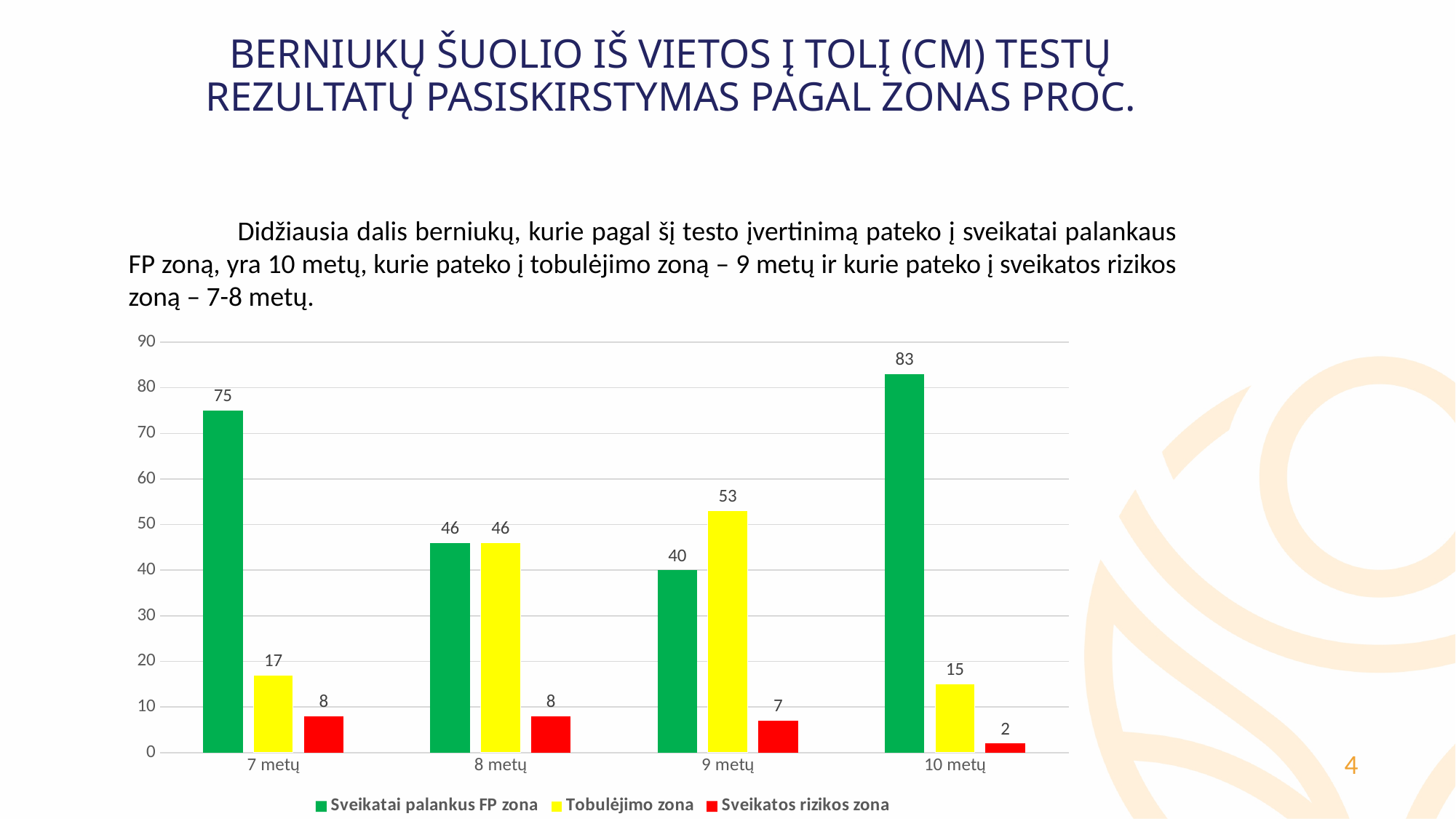
Which is larger for 9 metų: Sveikatai palankus FP zona or Tobulėjimo zona? Tobulėjimo zona What is the value for Tobulėjimo zona for 9 metų? 53 What kind of chart is shown on the slide? Bar chart Which age group has the highest value for Sveikatai palankus FP zona? 10 metų What colour represents Sveikatos rizikos zona in the chart? Red What is the value for Sveikatai palankus FP zona for 7 metų? 75 What is the difference between the Sveikatai palankus FP zona values for 10 metų and 9 metų? 43 Does the Tobulėjimo zona value rise or fall from 9 metų to 10 metų? Fall How many age groups are shown on the x axis? 4 How many series does the legend list? 3 Which age group has the lowest value for Sveikatos rizikos zona? 10 metų What is the value for Sveikatos rizikos zona for 10 metų? 2